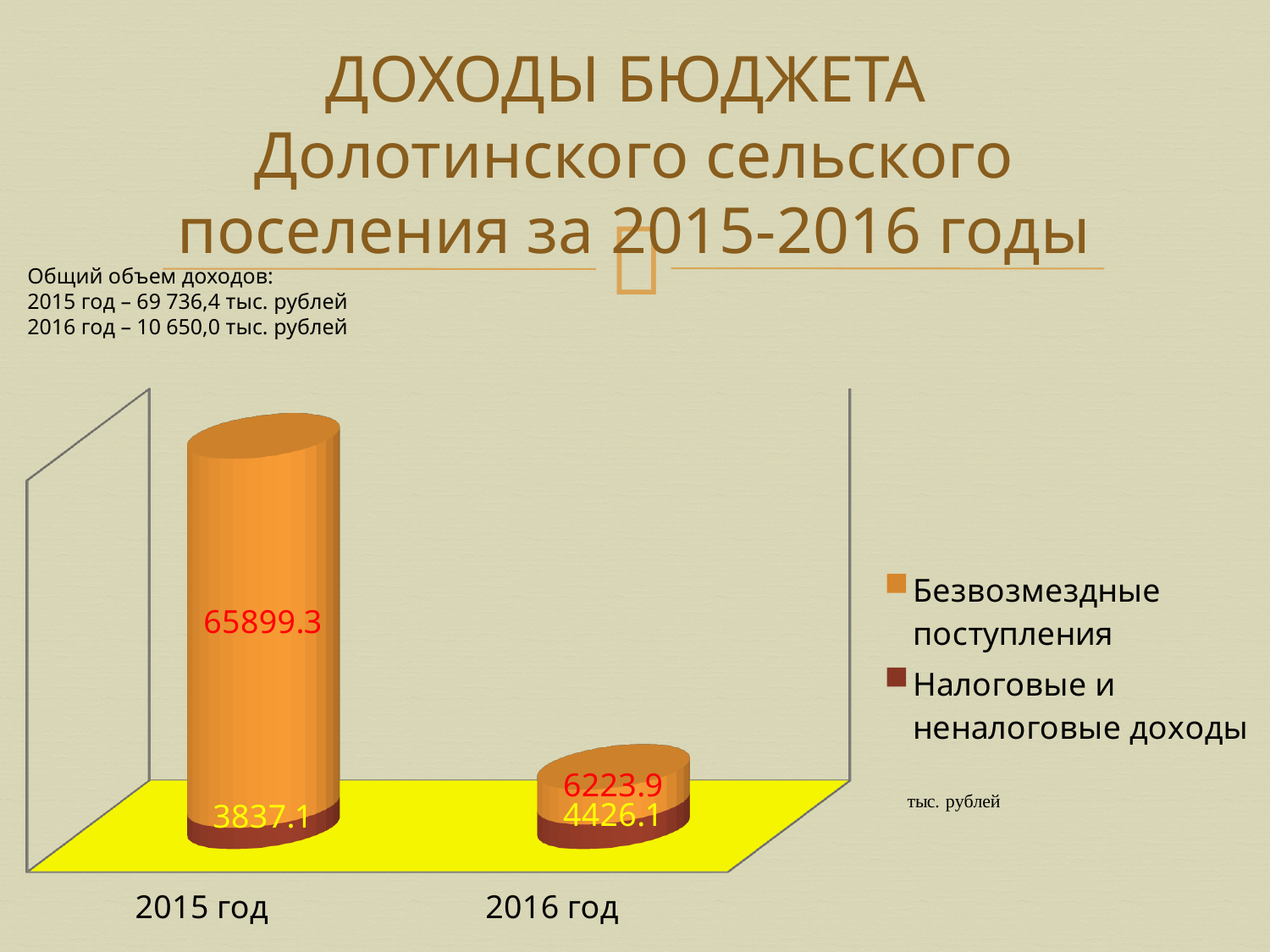
Which year has the larger value for Налоговые и неналоговые доходы, 2015 год or 2016 год? 2016 год What is the value of Налоговые и неналоговые доходы for 2016 год? 4426.1 How many series does the legend list? 2 What is the value of Налоговые и неналоговые доходы for 2015 год? 3837.1 How many categories (years) are shown on the x axis? 2 What is the total of the stacked bar for 2016 год? 10650.0 What is the value of Безвозмездные поступления for 2015 год? 65899.3 What type of chart is shown on the slide? bar chart What is the value of Безвозмездные поступления for 2016 год? 6223.9 What is the total of the stacked bar for 2015 год? 69736.4 What is the difference between Безвозмездные поступления in 2015 год and in 2016 год? 59675.4 Which colour represents Безвозмездные поступления in the legend? orange